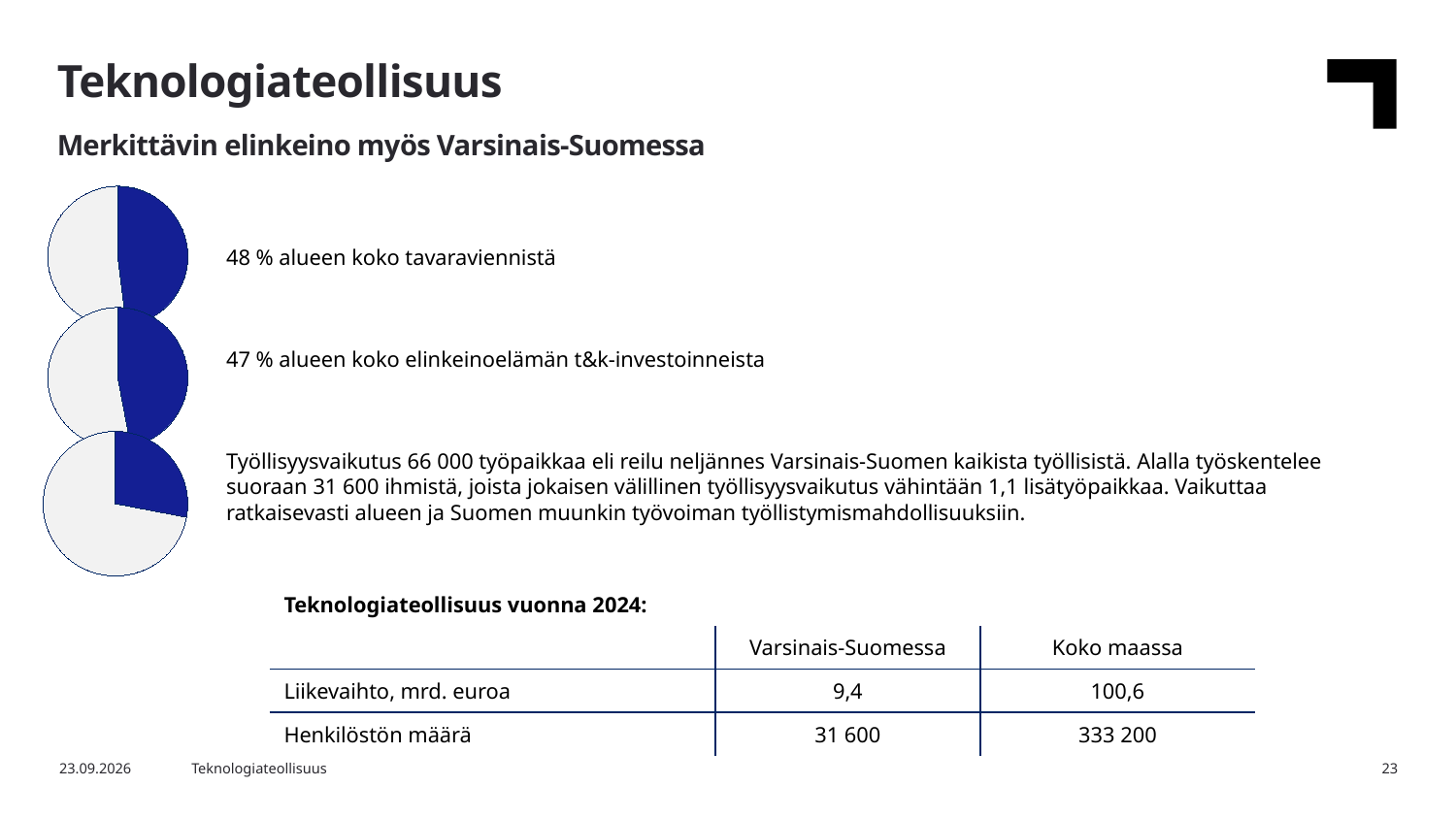
How many pie charts are on the slide? 3 Which pie chart shows the smallest highlighted share: the top, middle or bottom one? Bottom In the top pie chart, what share of the region's total goods exports does the highlighted slice represent? 48 % Is the highlighted slice larger in the middle pie chart or in the bottom pie chart? Middle What kind of charts are shown on the left side of the slide? Pie charts What does the top pie chart's highlighted slice represent, according to the text next to it? Alueen koko tavaraviennistä What colour is the highlighted slice in the pie charts? Blue In the middle pie chart, what share of the region's business R&D investments does the highlighted slice represent? 47 % Is the highlighted slice larger in the top pie chart or in the bottom pie chart? Top How many slices does each pie chart have? 2